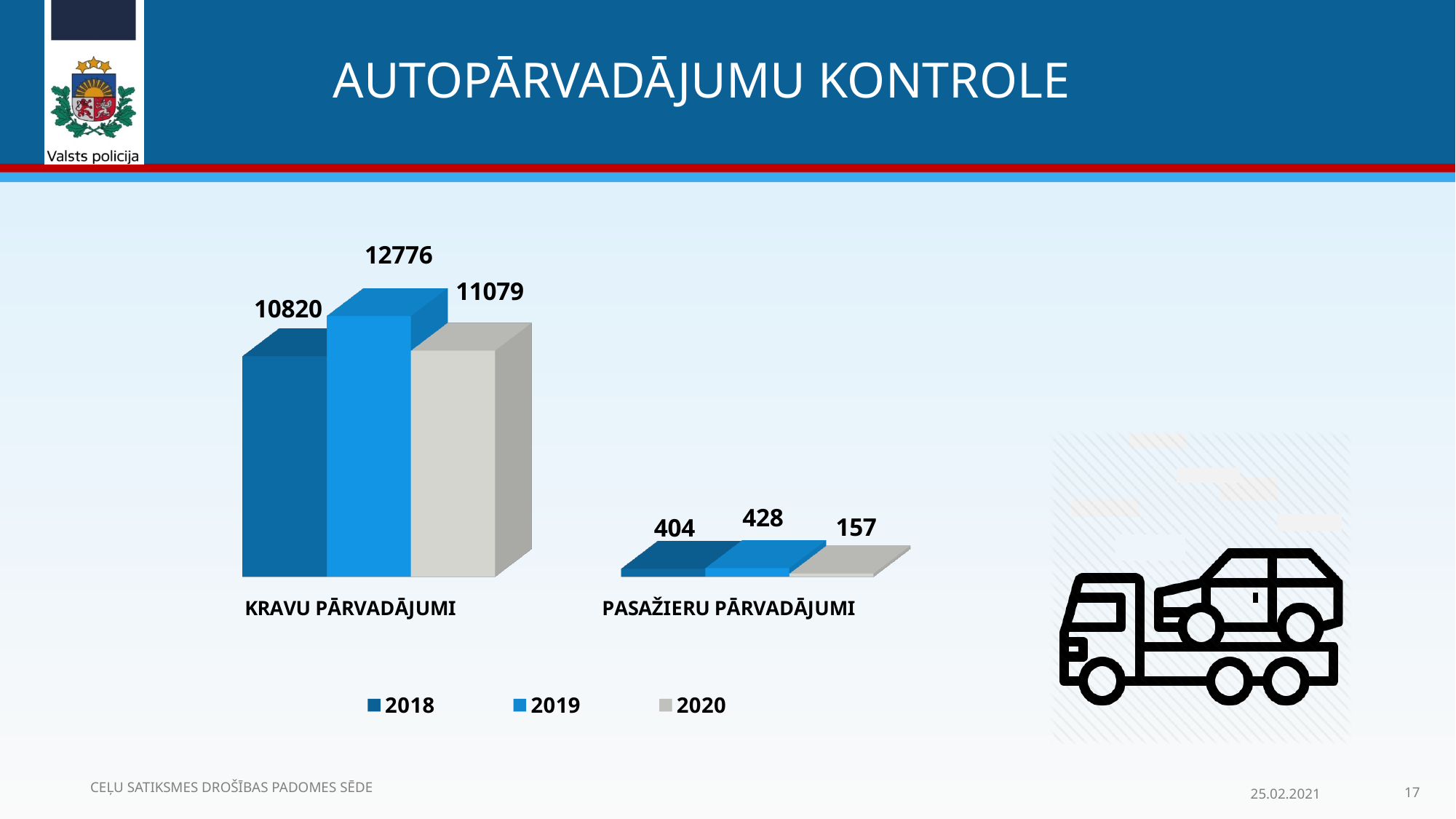
What kind of chart is shown on the slide? Bar chart What is the difference between the 2019 and 2018 values for KRAVU PĀRVADĀJUMI? 1956 Which year has the highest value for KRAVU PĀRVADĀJUMI? 2019 Which year has the lowest value for PASAŽIERU PĀRVADĀJUMI? 2020 Which is larger for PASAŽIERU PĀRVADĀJUMI: the 2018 value or the 2019 value? 2019 What is the difference between the 2019 and 2020 values for PASAŽIERU PĀRVADĀJUMI? 271 How many series does the legend list? 3 What is the value for 2019 in the KRAVU PĀRVADĀJUMI category? 12776 What is the value for 2018 in the KRAVU PĀRVADĀJUMI category? 10820 What is the value for 2020 in the PASAŽIERU PĀRVADĀJUMI category? 157 Which year is represented by the grey bars in the legend? 2020 How many categories are shown on the x axis? 2